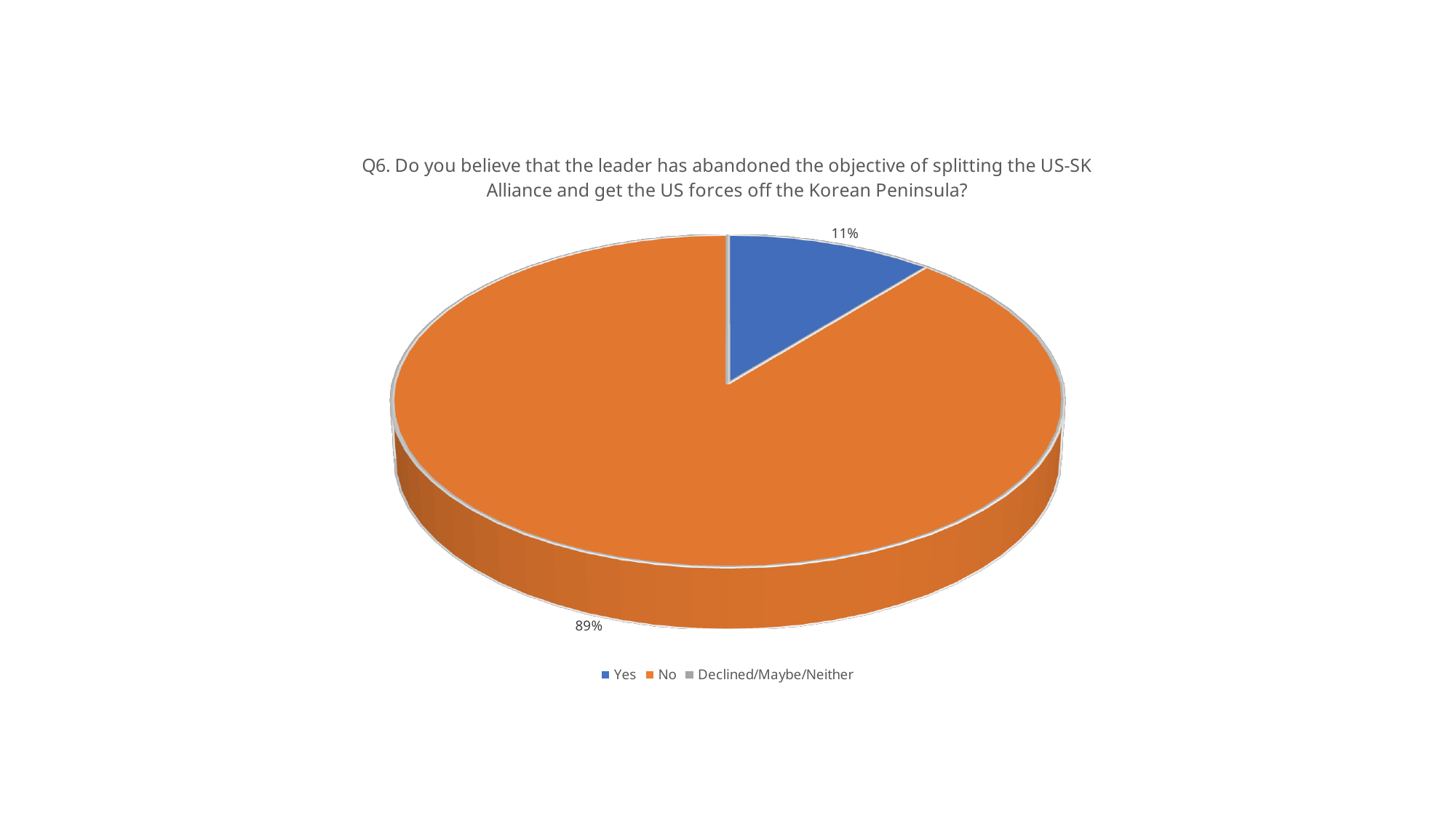
What kind of chart is shown on the slide? pie chart What colour is the "No" slice? orange What percentage of respondents answered "Yes"? 11% How many entries does the legend list? 3 What percentage of respondents answered "No"? 89% Which response has the largest share of the pie? No What is the difference in percentage points between the "No" and "Yes" slices? 78 How many slices are visible in the pie? 2 Which of the two labelled slices is larger, "Yes" or "No"? No What is the third legend entry after "Yes" and "No"? Declined/Maybe/Neither Is the share for "Yes" greater or less than 50%? less